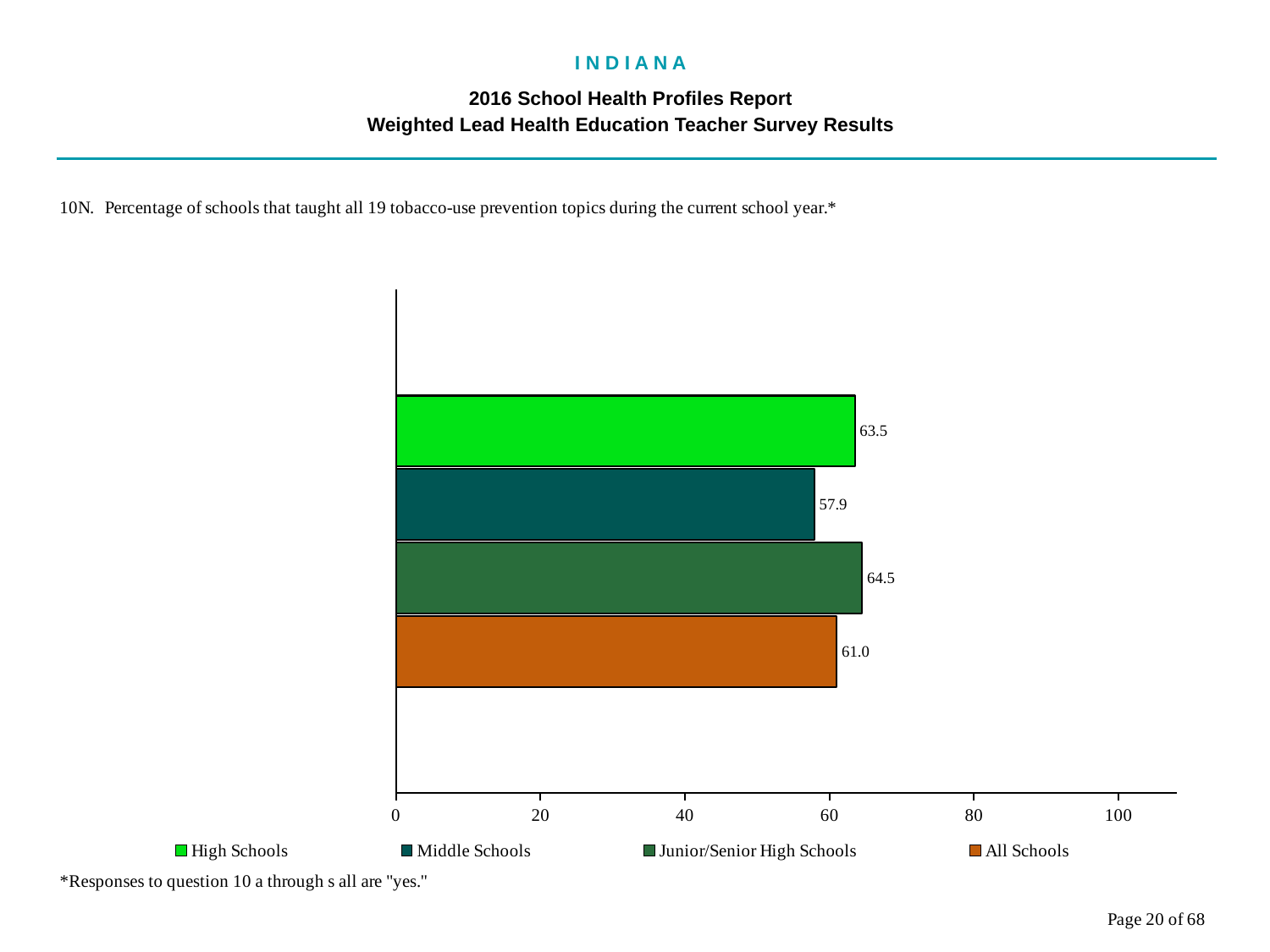
What kind of chart is shown on the slide? bar chart Which school type has the highest value? Junior/Senior High Schools What is the value for Junior/Senior High Schools? 64.5 How many series does the legend list? 4 What is the value for Middle Schools? 57.9 What is the value for High Schools? 63.5 Which school type has the lowest value? Middle Schools What is the value for All Schools? 61.0 What is the difference between the values for High Schools and Middle Schools? 5.6 How many bars are shown in the chart? 4 Is the value for Middle Schools greater or less than 60? less Which is larger, the value for All Schools or the value for Middle Schools? All Schools